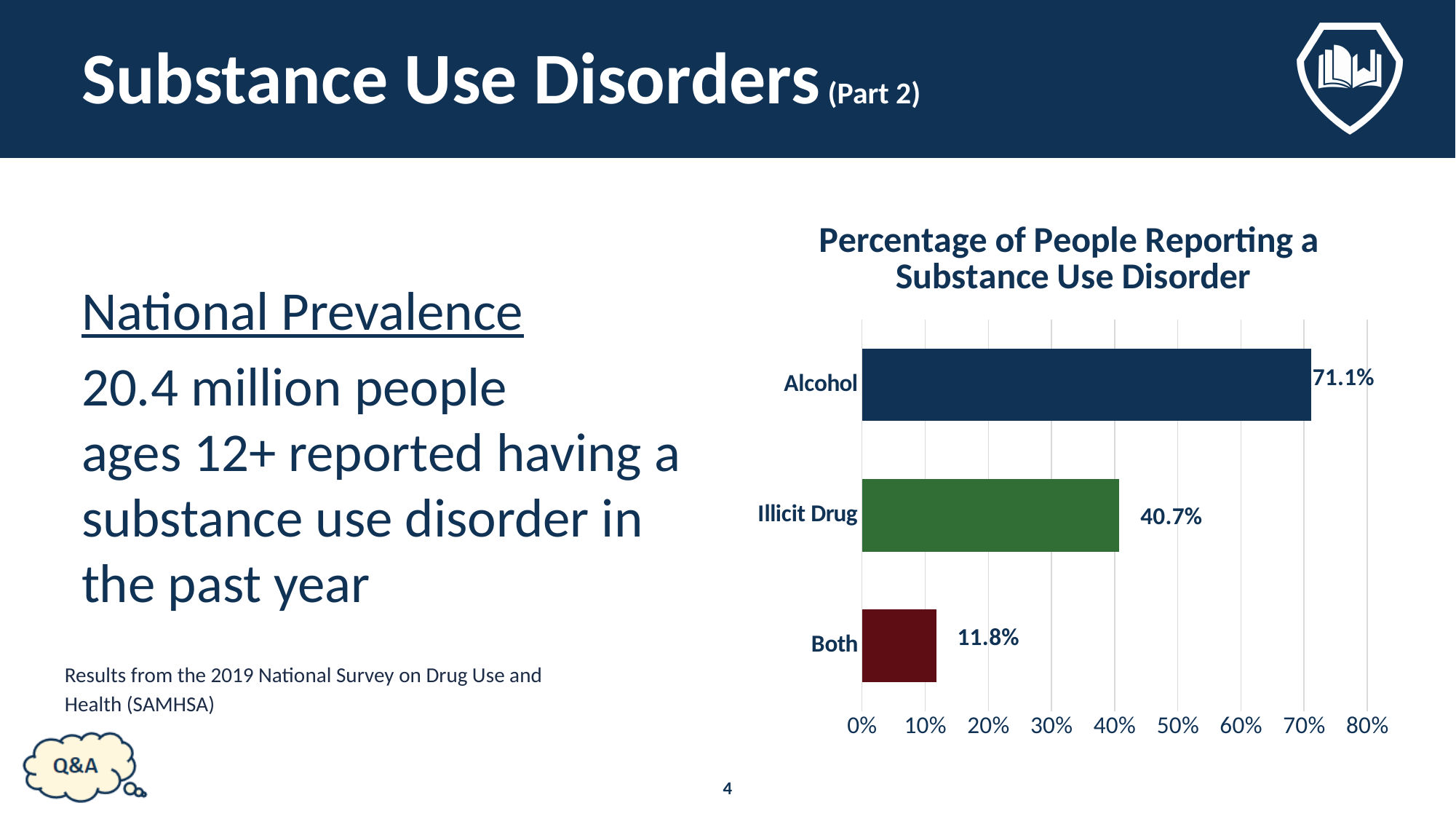
What is the value shown for Illicit Drug? 40.7% Is the value for Alcohol greater or less than 60%? greater How many categories are shown in the chart? 3 What percentage of people reported an alcohol substance use disorder? 71.1% Which category has the lowest percentage? Both What kind of chart is shown on the slide? Bar chart What is the difference between the Illicit Drug and Both percentages? 28.9% What is the title of the chart? Percentage of People Reporting a Substance Use Disorder Which is larger, the value for Illicit Drug or the value for Both? Illicit Drug What is the difference between the Alcohol and Illicit Drug percentages? 30.4% Which category has the highest percentage? Alcohol What percentage is shown for the Both category? 11.8%